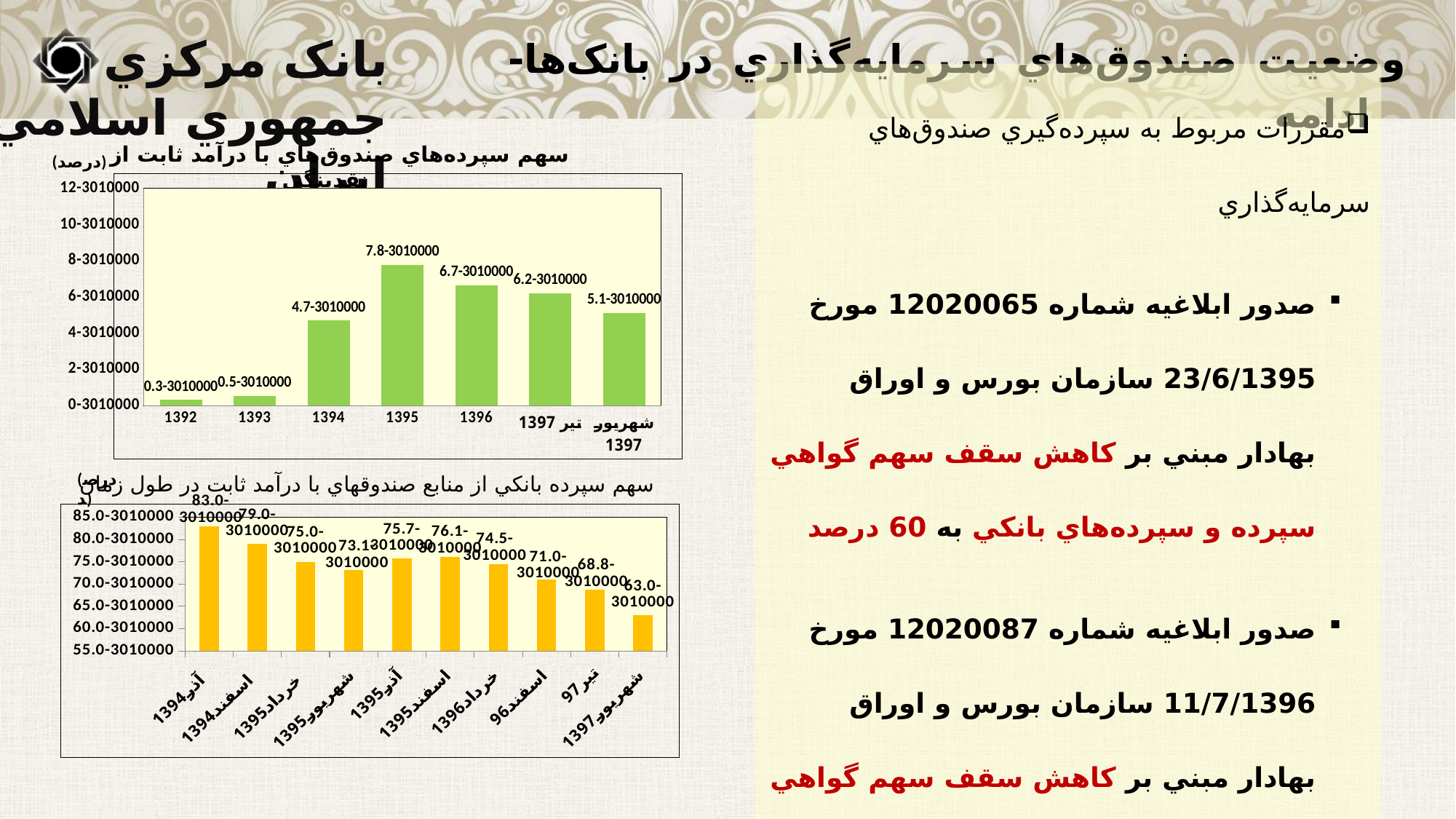
On the bottom chart, what colour are the bars? yellow/orange On the top chart, what is the data label printed above the bar for 1395? 7.8-3010000 On the top chart, what type of chart is shown? bar chart On the top chart, which category has the lowest bar? 1392 On the bottom chart, which category has the lowest bar? شهریور 1397 On the bottom chart, which category has the highest bar? آذر 1394 On the top chart, is the value for 1393 greater or less than 2 on the axis? less On the top chart, which category has the highest bar? 1395 On the bottom chart, how many bars are plotted? 10 On the top chart, how many bars are plotted? 7 On the top chart, is the bar for 1394 taller or shorter than the bar for 1396? shorter On the bottom chart, what is the data label printed above the bar for شهریور 1397? 63.0-3010000